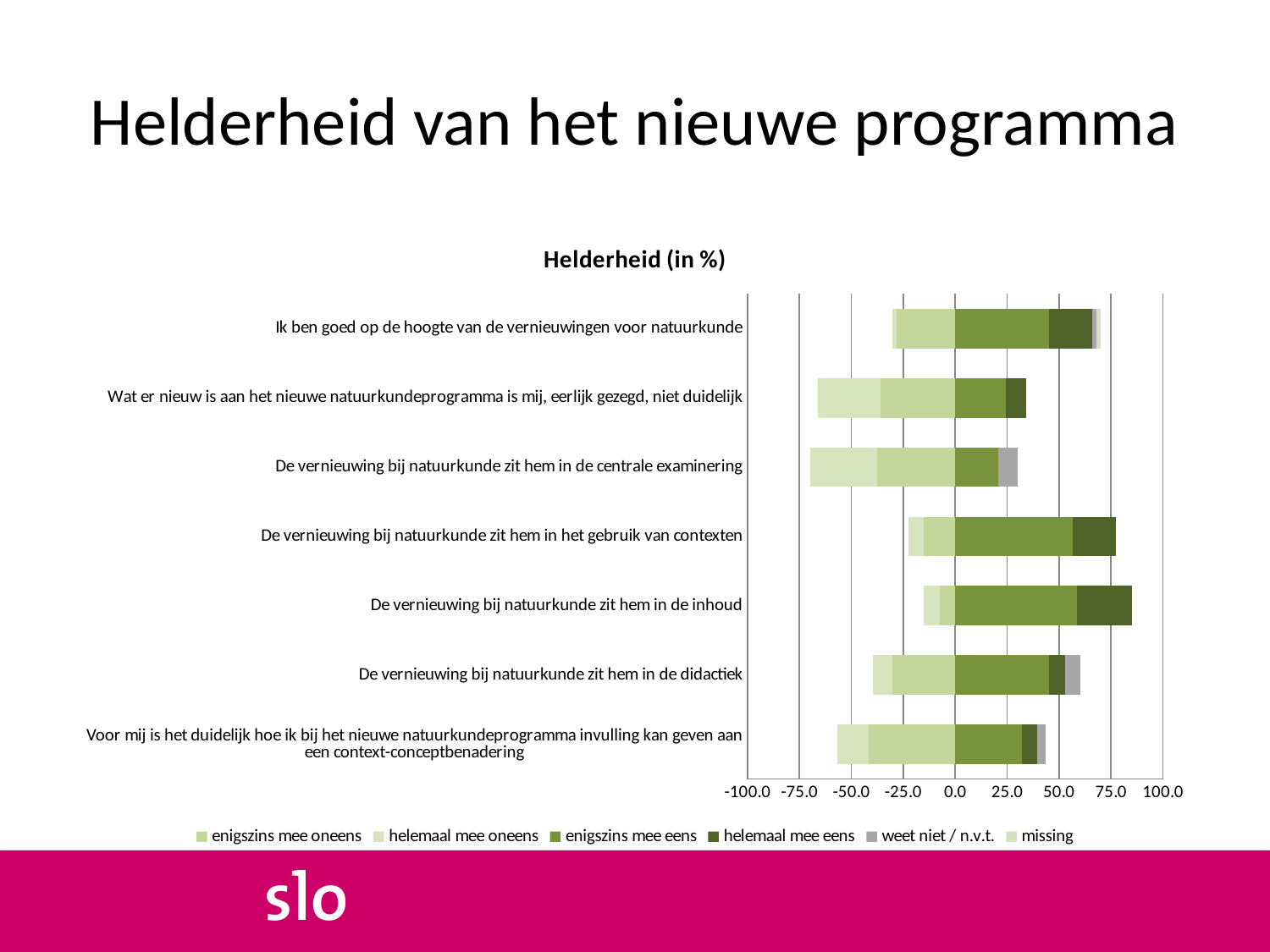
Is the negative (disagree) side of the bar for 'De vernieuwing bij natuurkunde zit hem in de didactiek' greater or less than -25.0? less How many statements (categories) are plotted in the chart? 7 Is the negative (disagree) side of the bar for 'De vernieuwing bij natuurkunde zit hem in de centrale examinering' greater or less than -50.0? less Which statement has the longest bar on the positive (agree) side of the axis? De vernieuwing bij natuurkunde zit hem in de inhoud Which legend entry is listed first? enigszins mee oneens Is the positive (agree) side of the bar for 'De vernieuwing bij natuurkunde zit hem in de inhoud' greater or less than 75.0? greater What is the title of the chart? Helderheid (in %) What kind of chart is shown on the slide? bar chart How many series does the legend list? 6 Which extends further on the positive (agree) side: the bar for 'De vernieuwing bij natuurkunde zit hem in de inhoud' or the bar for 'Wat er nieuw is aan het nieuwe natuurkundeprogramma is mij, eerlijk gezegd, niet duidelijk'? De vernieuwing bij natuurkunde zit hem in de inhoud